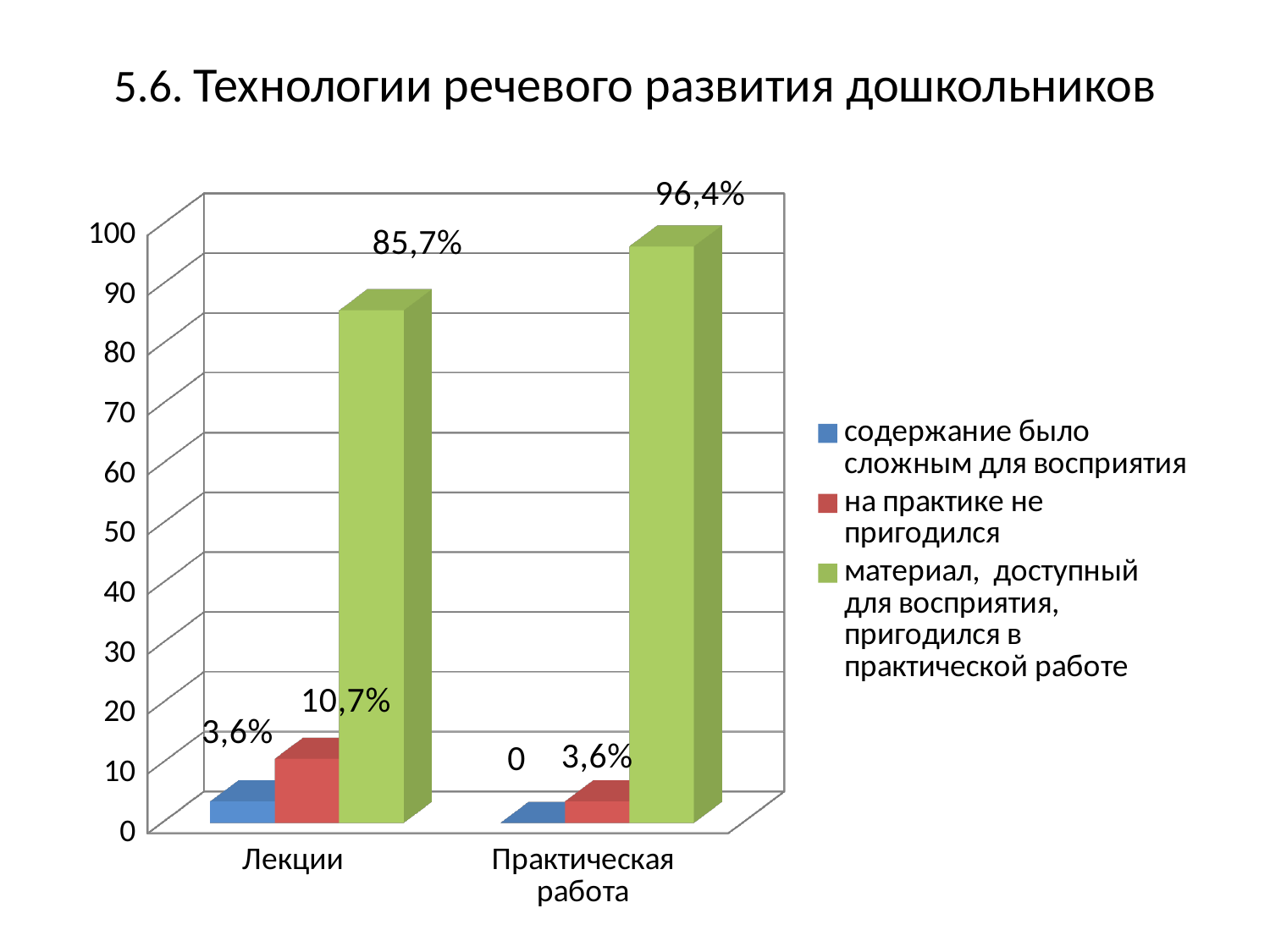
What is the value for "содержание было сложным для восприятия" for Практическая работа? 0 Which series has the lowest value for Лекции? содержание было сложным для восприятия What is the difference between the "материал, доступный для восприятия, пригодился в практической работе" values for Практическая работа and Лекции? 10,7% What colour represents the series "на практике не пригодился"? Red What is the value for "на практике не пригодился" for Практическая работа? 3,6% How many series does the legend list? 3 What is the value for "материал, доступный для восприятия, пригодился в практической работе" for Лекции? 85,7% Which category has the higher value for "материал, доступный для восприятия, пригодился в практической работе"? Практическая работа How many categories are shown on the x axis? 2 What is the value for "материал, доступный для восприятия, пригодился в практической работе" for Практическая работа? 96,4% What is the value for "на практике не пригодился" for Лекции? 10,7% What kind of chart is shown on the slide? Bar chart